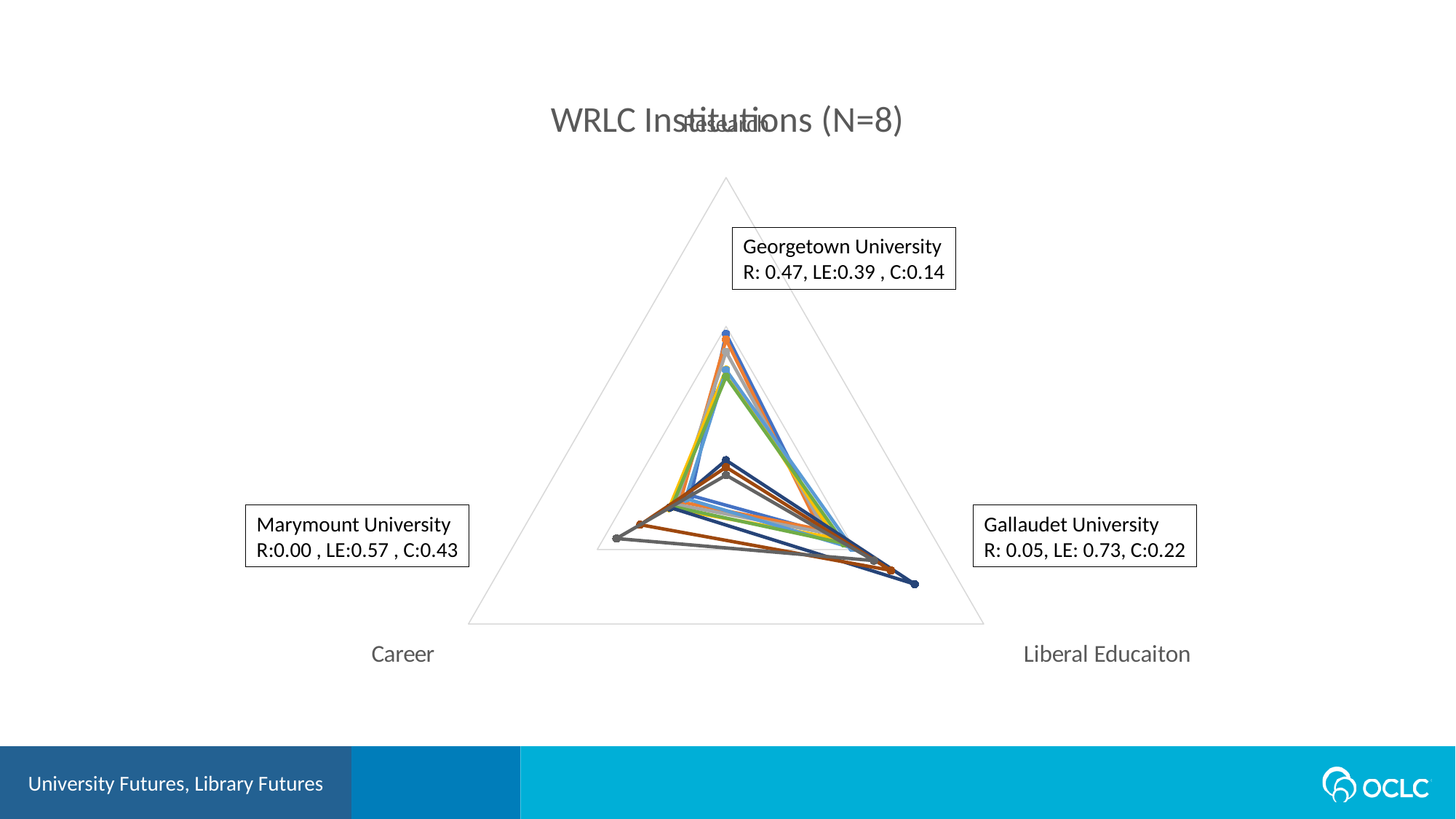
What is the Research (R) value shown for Georgetown University? 0.47 How many axes (categories) does the radar chart have? 3 What is the Research (R) value shown for Marymount University? 0.00 What kind of chart is shown on the slide? Radar chart Which has a higher Liberal Education (LE) value, Georgetown University or Gallaudet University? Gallaudet University How many institutions are included in the chart according to the title? 8 What is the Liberal Education (LE) value shown for Gallaudet University? 0.73 What are the three axis labels on the radar chart? Research, Career, Liberal Educaiton What is the difference between the Research (R) values of Georgetown University and Gallaudet University? 0.42 What is the Career (C) value shown for Marymount University? 0.43 Which of the three labelled dimensions has the highest value for Georgetown University? Research What is the title of the chart? WRLC Institutions (N=8)